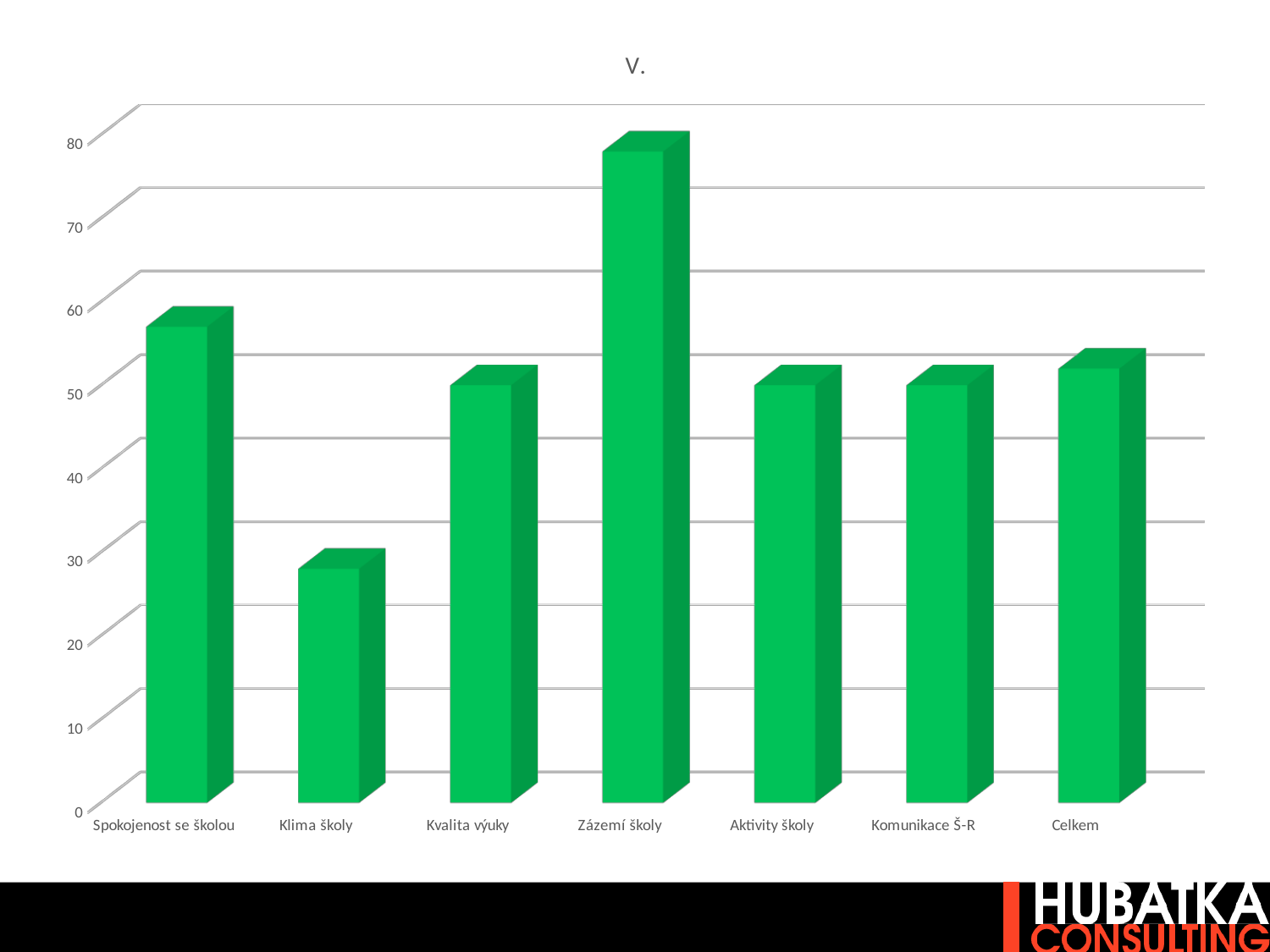
How many categories are shown on the x axis of the chart? 7 Is the value for Zázemí školy greater or less than 70? greater Which category has the highest bar? Zázemí školy What is the title of the chart? V. What colour are the bars in the chart? green Which category has the lowest bar? Klima školy Is the value for Celkem greater or less than 60? less Is the value for Klima školy greater or less than 40? less What kind of chart is shown on the slide? bar chart Which is larger, the value for Spokojenost se školou or the value for Klima školy? Spokojenost se školou Which is larger, the value for Zázemí školy or the value for Celkem? Zázemí školy